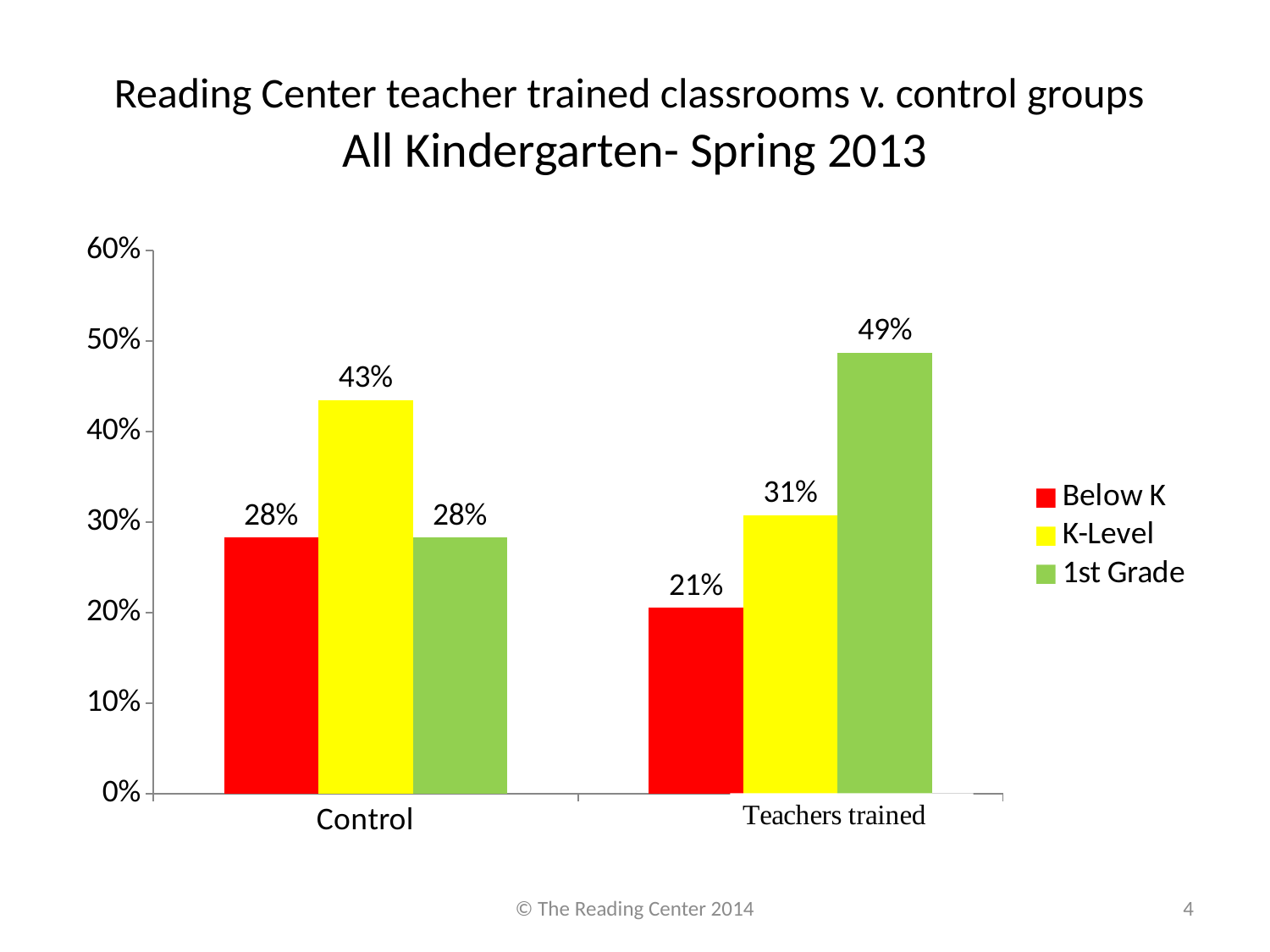
How many series does the legend list? 3 How many categories are shown on the x axis? 2 What kind of chart is shown on the slide? bar chart Which is larger: the K-Level value for Control or for Teachers trained? Control What is the value for Below K in the Control group? 28% Which series has the lowest value in the Teachers trained group? Below K What is the difference between the 1st Grade values for Teachers trained and Control? 21% Is the value for Below K in the Teachers trained group greater or less than 30%? less Which series has the highest value in the Teachers trained group? 1st Grade What is the value for 1st Grade in the Teachers trained group? 49% What colour represents the K-Level series? yellow What is the value for K-Level in the Control group? 43%